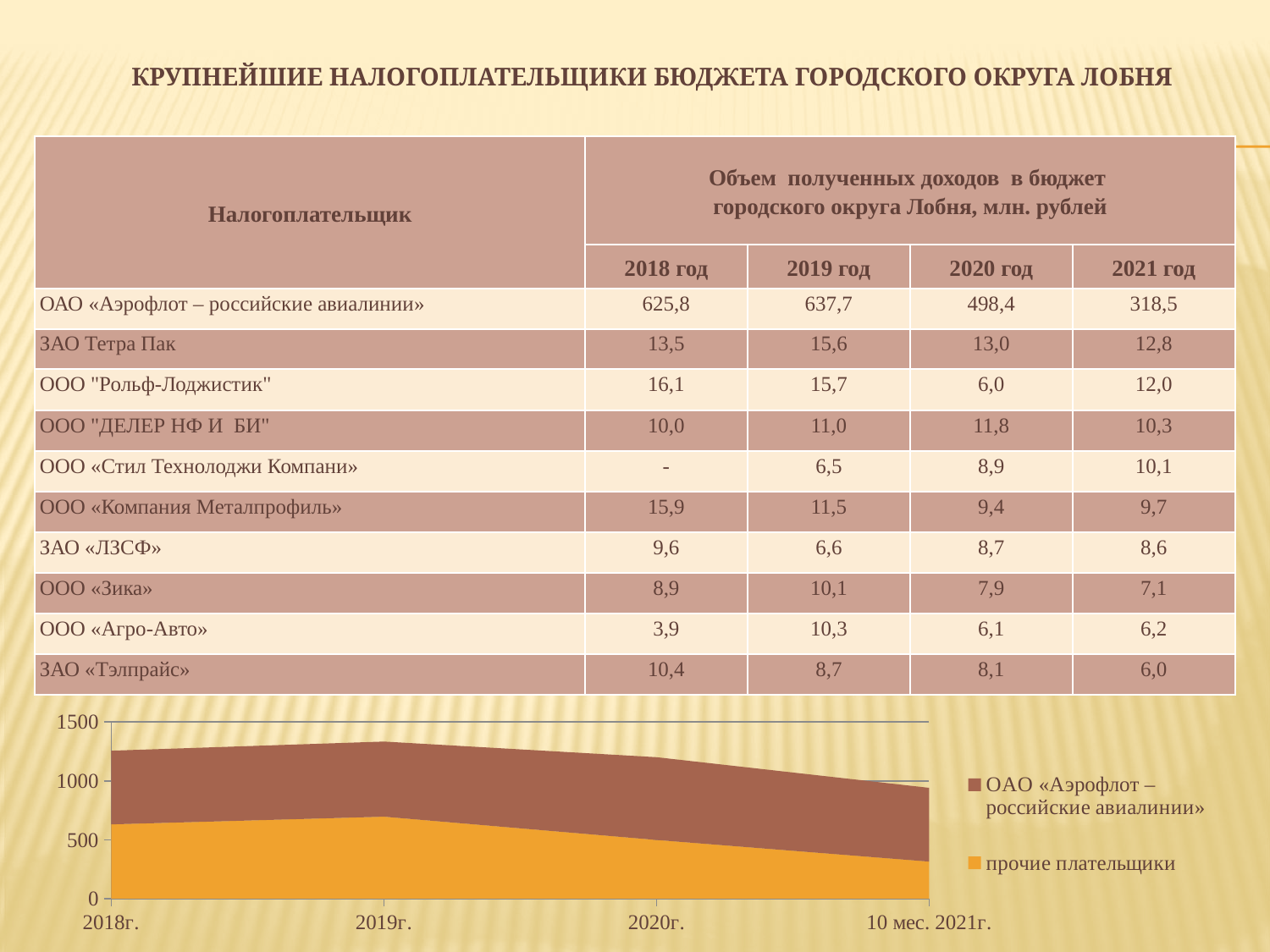
In the area chart, is the total value for 10 мес. 2021г. greater or less than 1000? less In the area chart, is the total value for 2018г. greater or less than 1000? greater In the area chart, which period has the lowest total value? 10 мес. 2021г. In the area chart, is the value for прочие плательщики in 2019г. greater or less than 500? greater In the area chart, does the total value rise or fall from 2019г. to 10 мес. 2021г.? fall How many series does the legend of the area chart list? 2 What is the highest tick value on the vertical axis of the area chart? 1500 In the area chart, which period has the highest value for прочие плательщики? 2019г. What kind of chart is shown at the bottom of the slide? Stacked area chart How many periods are shown along the x axis of the area chart? 4 Which series is shown in orange in the area chart? прочие плательщики